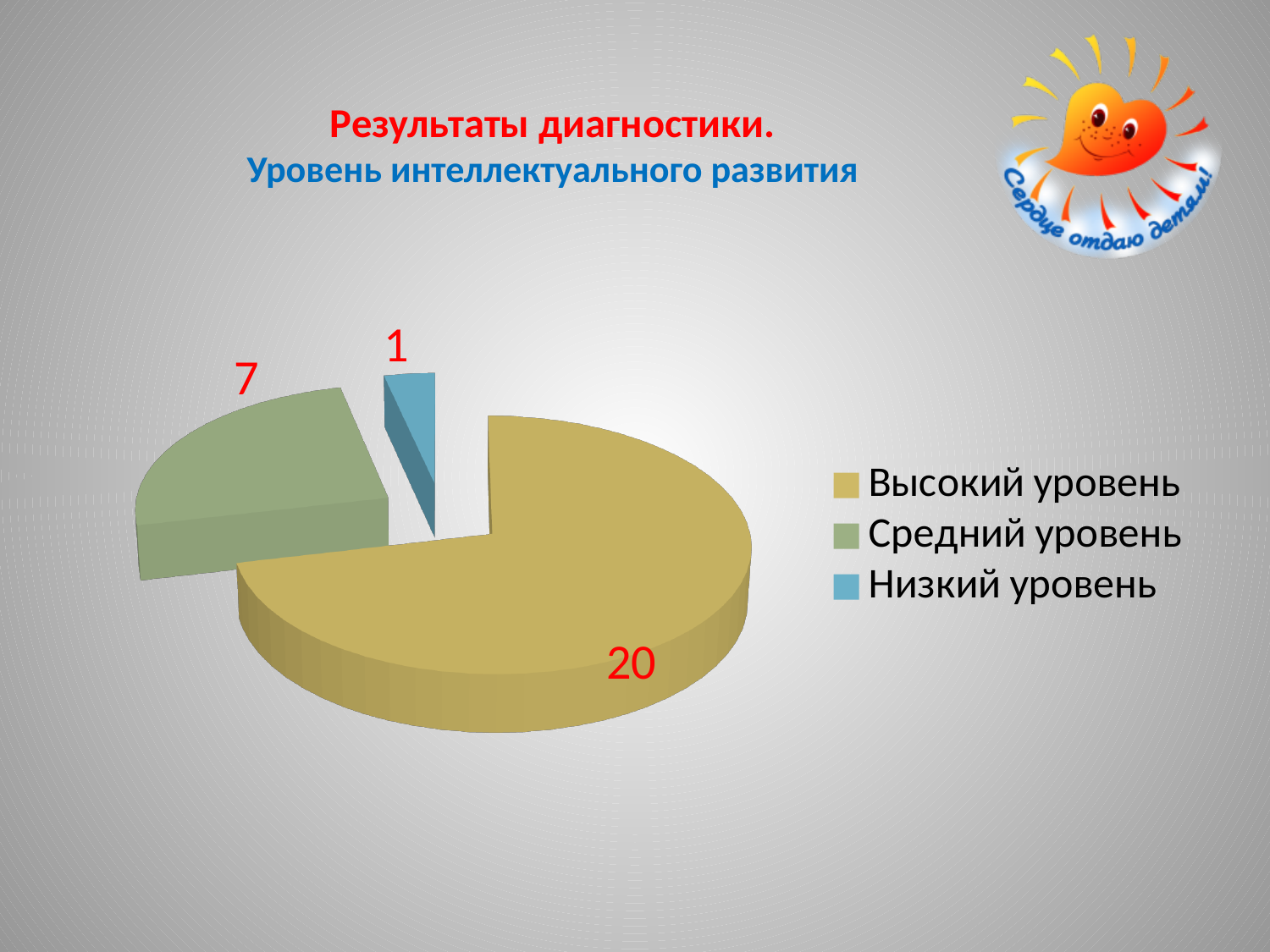
What is the difference between the values for Высокий уровень and Средний уровень? 13 Which is larger, the value for Средний уровень or the value for Низкий уровень? Средний уровень What is the value for Высокий уровень? 20 What is the difference between the values for Средний уровень and Низкий уровень? 6 What is the total of all slices in the pie chart? 28 Which category has the largest slice? Высокий уровень What is the value for Низкий уровень? 1 What is the title of the chart on the slide? Результаты диагностики. Уровень интеллектуального развития How many slices does the pie chart have? 3 What kind of chart is shown on the slide? pie chart What is the value for Средний уровень? 7 Which category has the smallest slice? Низкий уровень